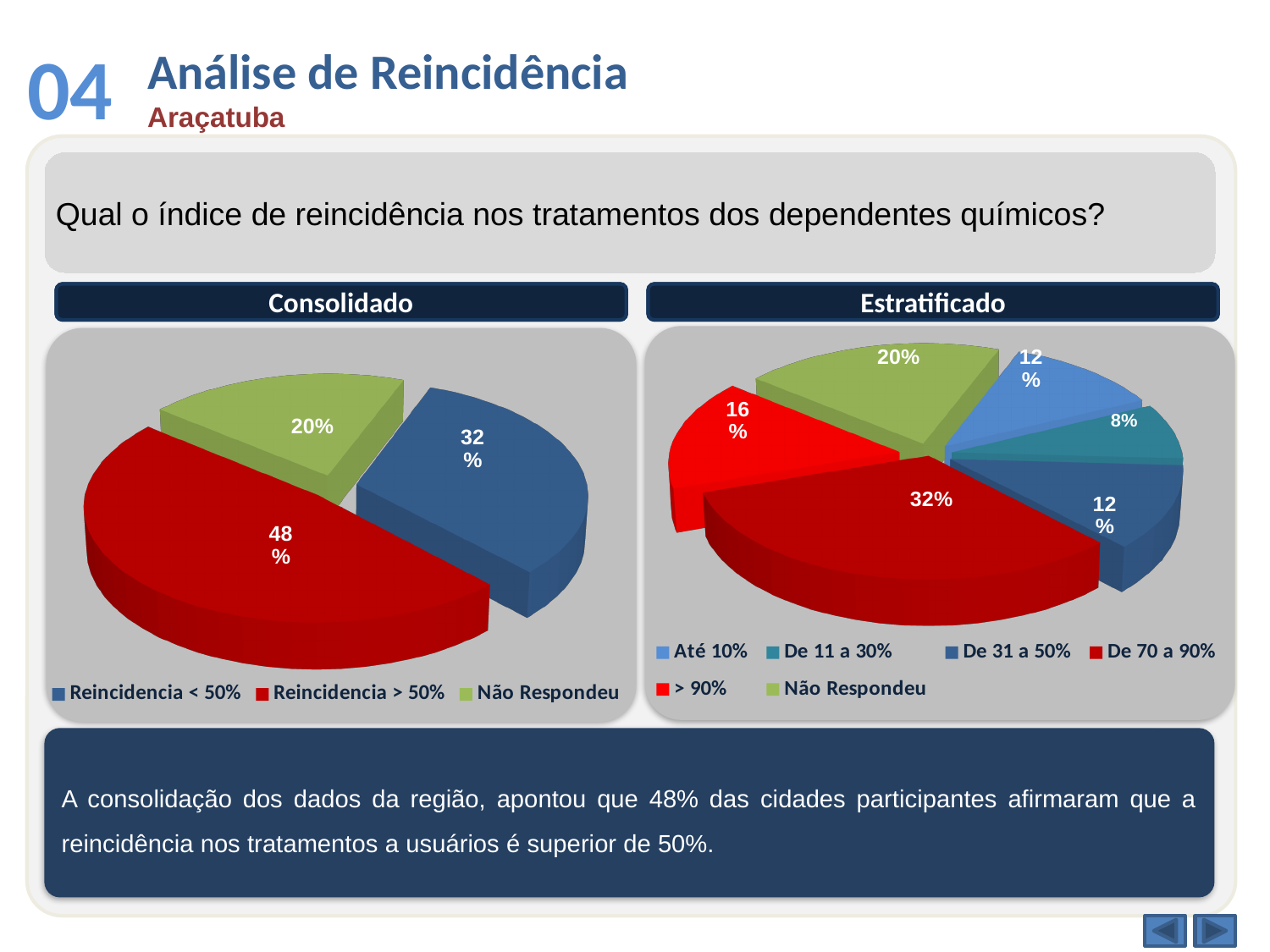
In the Estratificado chart, what is the difference between the De 70 a 90% share and the > 90% share? 16% In the Estratificado chart, what share is labelled for De 11 a 30%? 8% How many categories does the legend of the Estratificado chart list? 6 What kind of chart is the Consolidado chart? Pie chart In the Estratificado chart, which is larger: the > 90% slice or the Não Respondeu slice? Não Respondeu In the Consolidado chart, which category has the largest slice? Reincidencia > 50% In the Consolidado chart, what is the difference between the Reincidencia > 50% and Reincidencia < 50% shares? 16% In the Consolidado chart, what share is labelled for Reincidencia < 50%? 32% In the Estratificado chart, what share is labelled for De 70 a 90%? 32% In the Consolidado chart, which category has the smallest slice? Não Respondeu In the Estratificado chart, which category has the smallest slice? De 11 a 30% In the Consolidado chart, what share is labelled for Reincidencia > 50%? 48%